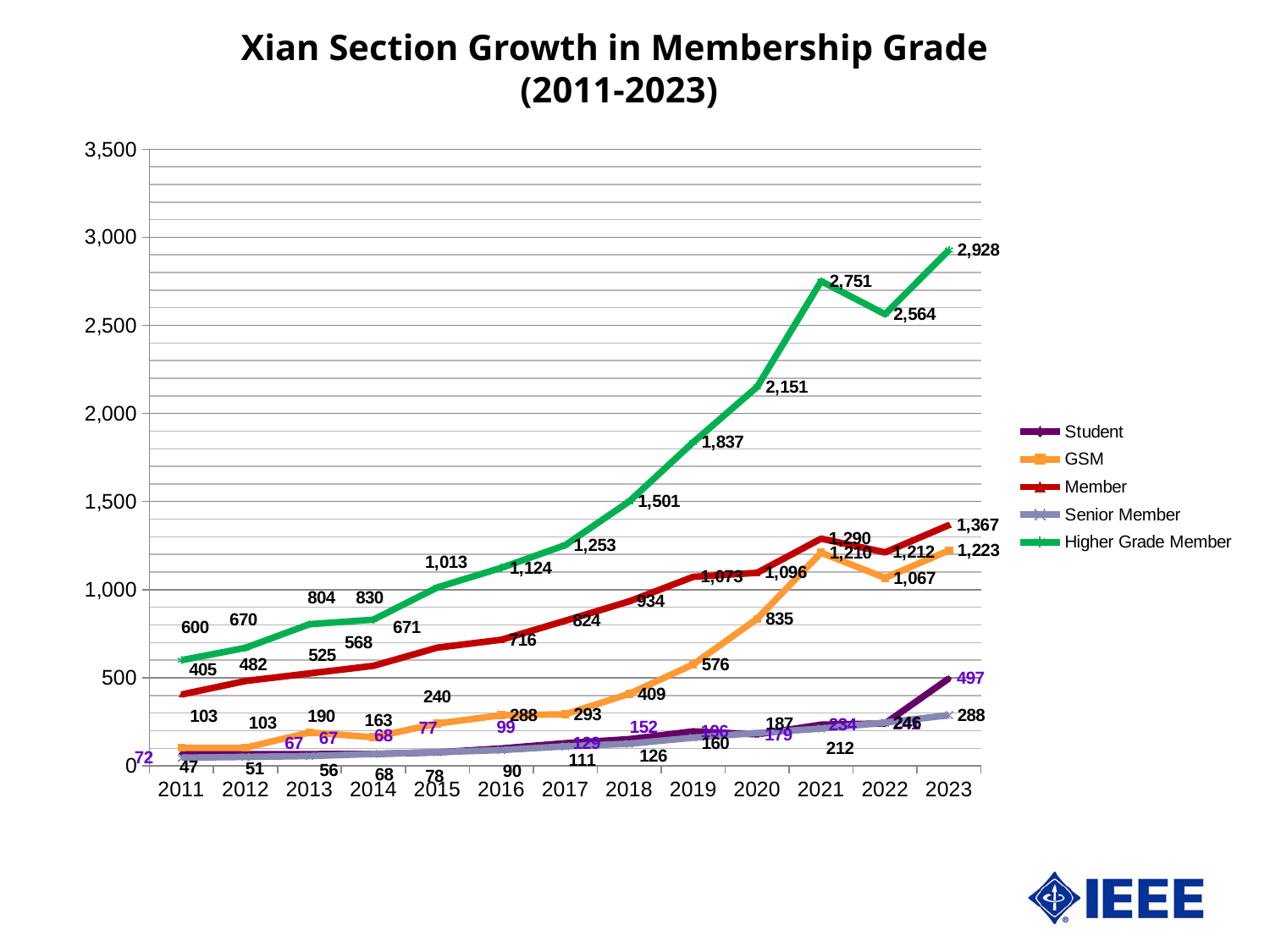
What is the difference between the Higher Grade Member values in 2021 and 2022? 187 How many years are shown on the x axis? 13 What is the difference between the Member and GSM values in 2023? 144 Is the value for Higher Grade Member in 2020 greater or less than 2,000? greater How many series does the legend list? 5 What is the value for Senior Member in 2023? 288 In which year is the Higher Grade Member value highest? 2023 What is the value for Member in 2021? 1,290 Which is larger in 2021, the Member value or the GSM value? Member In which year is the Member value lowest? 2011 What is the value for GSM in 2020? 835 What is the value for Higher Grade Member in 2023? 2,928